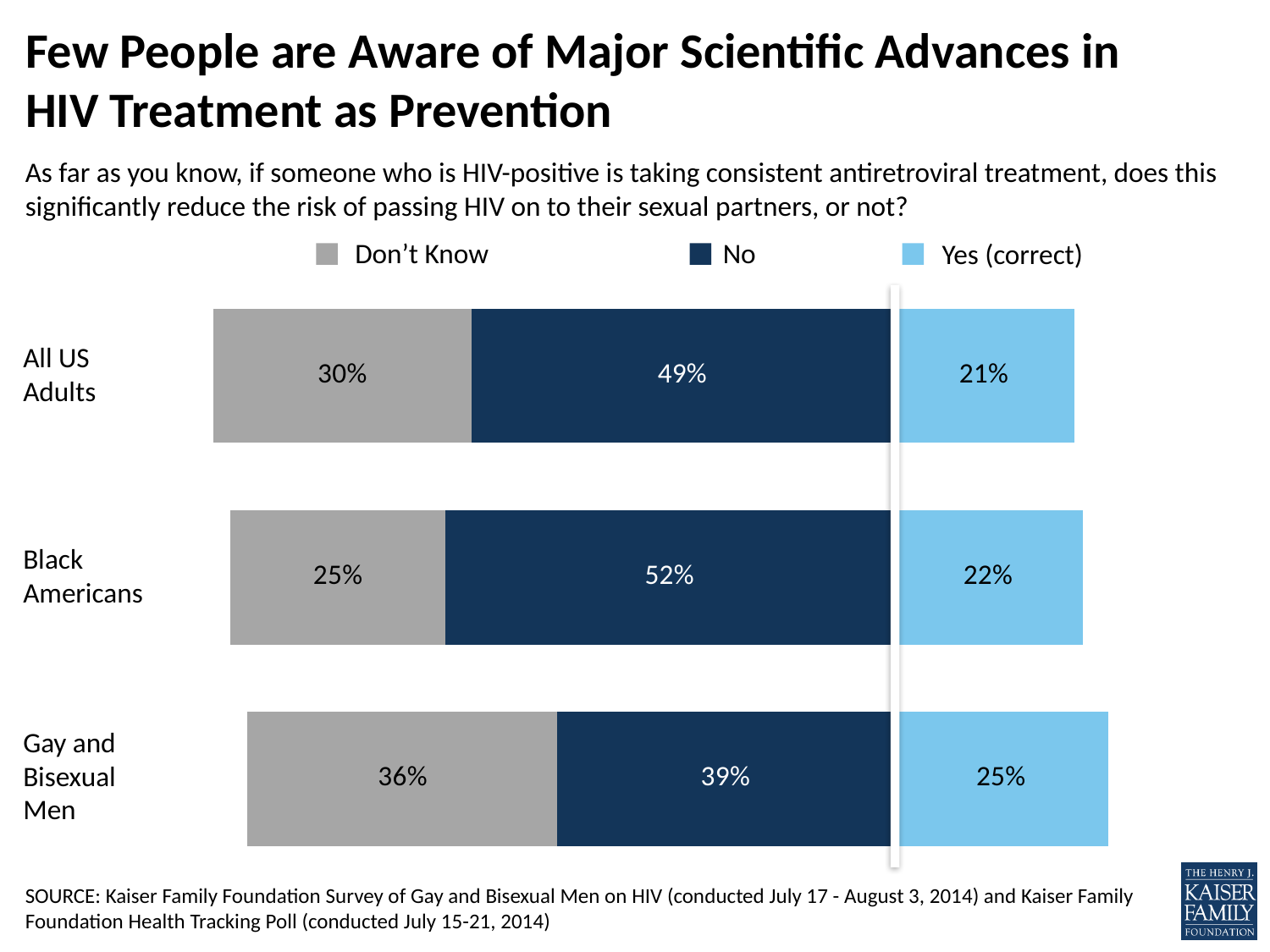
How many series does the legend list? 3 What is the total of the three segments for the All US Adults bar? 100% Which legend entry is marked as the correct answer? Yes (correct) Which is larger: the "Don't Know" share for All US Adults or for Gay and Bisexual Men? Gay and Bisexual Men What percentage of All US Adults answered "Yes (correct)"? 21% Which group has the highest share answering "Yes (correct)"? Gay and Bisexual Men What percentage of Gay and Bisexual Men answered "Don't Know"? 36% What kind of chart is shown on the slide? Stacked bar chart What is the difference between the "No" share for Black Americans and for Gay and Bisexual Men? 13 percentage points What percentage of Black Americans answered "No"? 52% Which group has the lowest share answering "Don't Know"? Black Americans How many groups are shown in the chart? 3